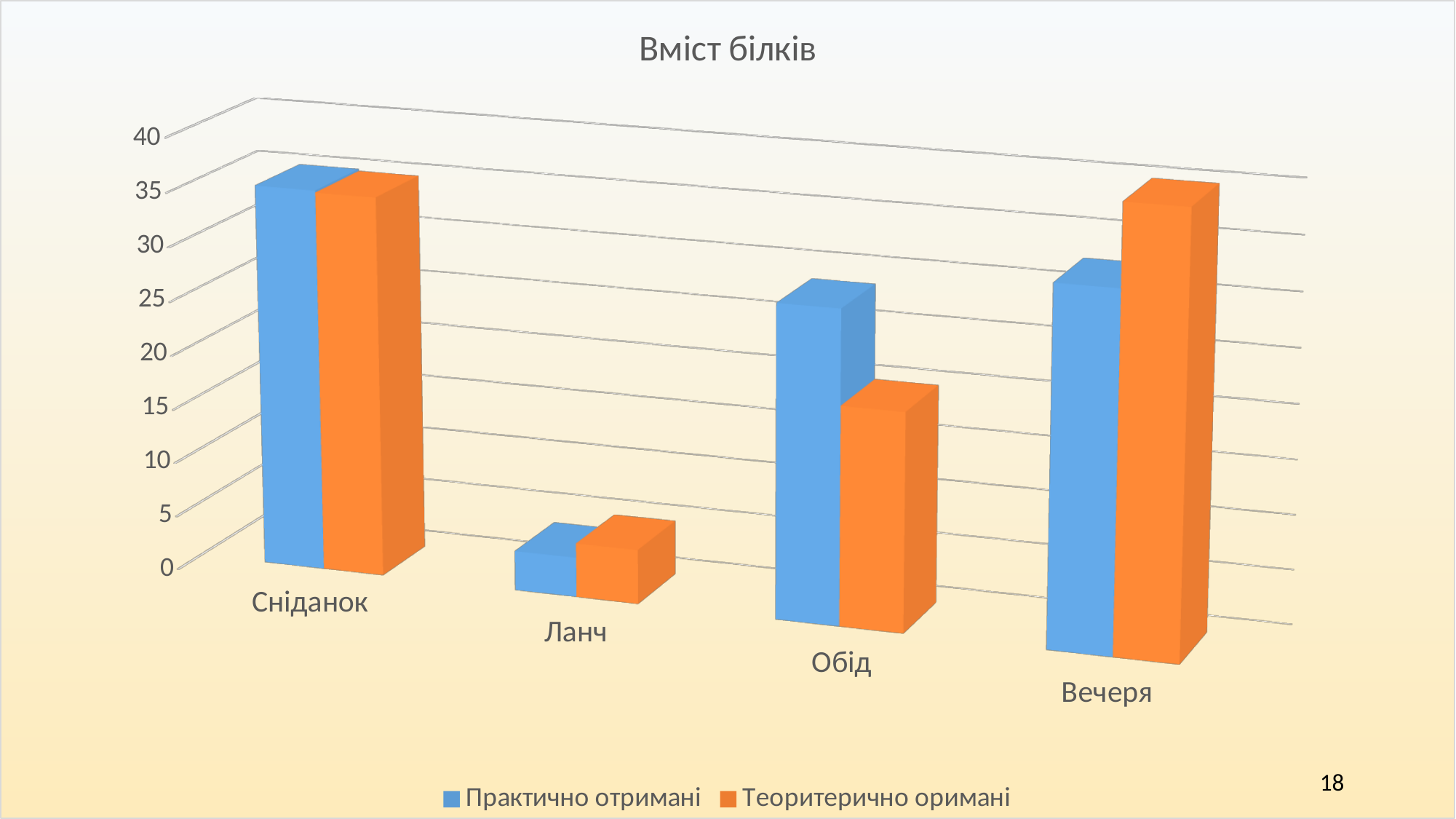
Is the value for Теоритерично оримані at Обід greater or less than 25? less For Вечеря, which series has the larger value: Практично отримані or Теоритерично оримані? Теоритерично оримані What is the title of the chart? Вміст білків What kind of chart is shown on the slide? bar chart For Обід, which series has the larger value: Практично отримані or Теоритерично оримані? Практично отримані How many categories are shown on the x axis? 4 Which category has the lowest value for the series Практично отримані? Ланч Which colour represents the series Теоритерично оримані in the legend? orange Is the value for Практично отримані at Обід greater or less than 20? greater How many series does the legend list? 2 Is the value for Практично отримані at Ланч greater or less than 10? less Which category has the lowest value for the series Теоритерично оримані? Ланч